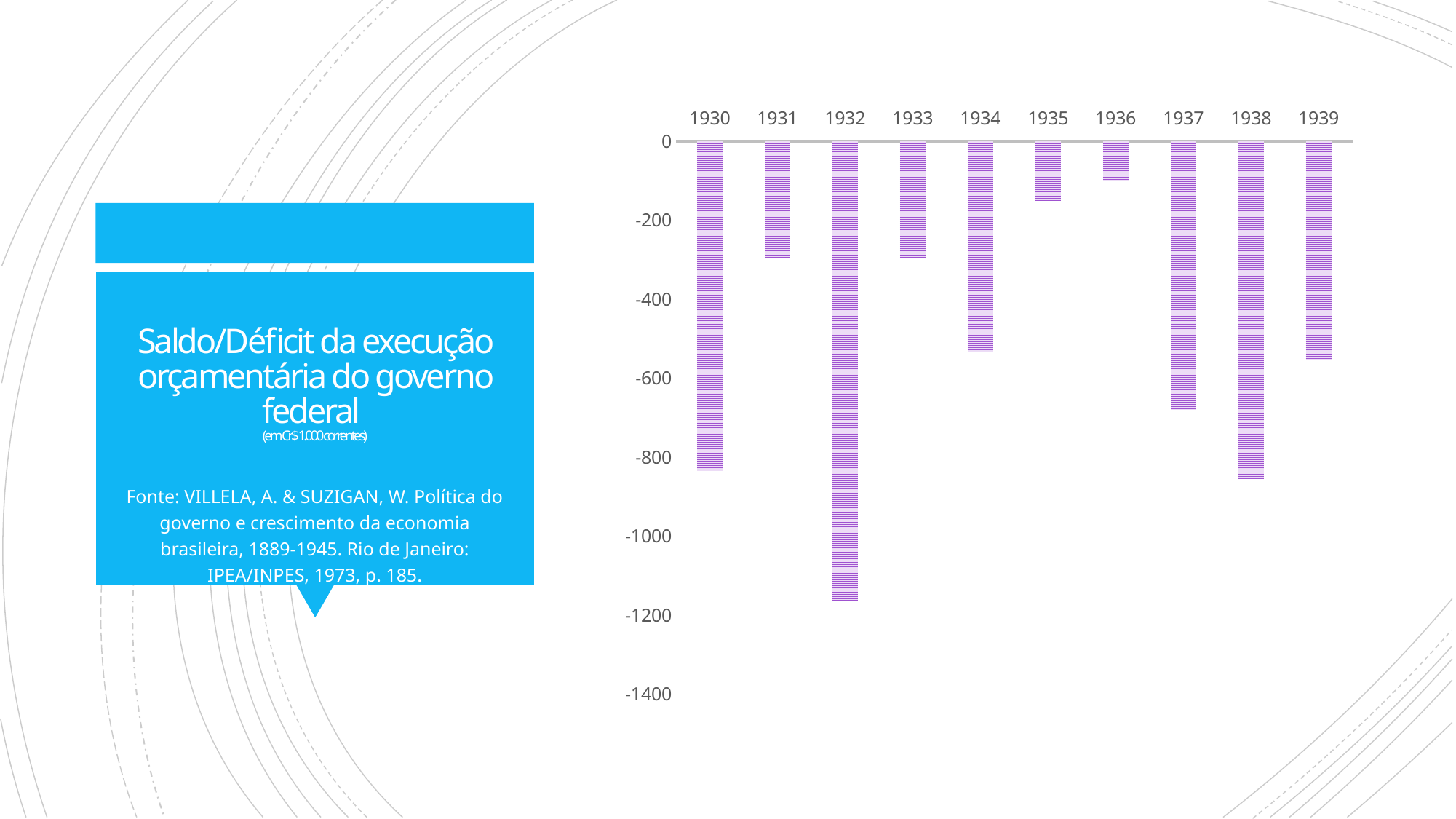
Is the value for 1938 greater or less than -800? less Is the value for 1932 greater or less than -1000? less Is the value for 1936 greater or less than -200? greater Which year shows a larger deficit, 1930 or 1932? 1932 Which year has the smallest deficit (the value closest to zero) on the chart? 1936 What is the title of the chart on the slide? Saldo/Déficit da execução orçamentária do governo federal Which year has the largest deficit (the most negative value) on the chart? 1932 Which year shows a larger deficit, 1935 or 1936? 1935 What kind of chart is shown on the slide? bar chart How many years are plotted on the chart? 10